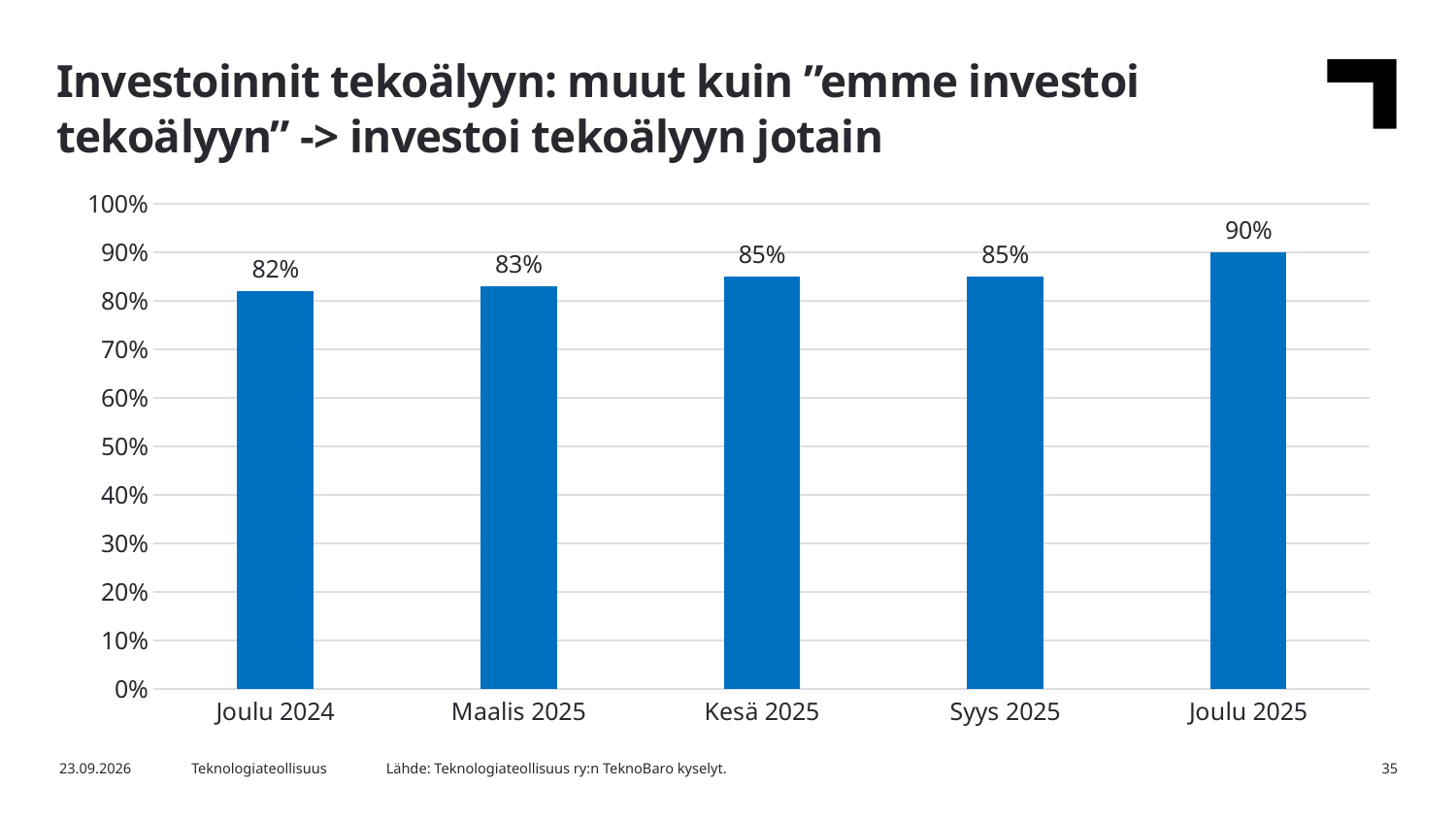
Which category has the lowest value? Joulu 2024 What kind of chart is shown on the slide? bar chart Is the value for Syys 2025 greater or less than 80%? greater What is the value for Kesä 2025? 85% What is the value for Maalis 2025? 83% What is the value for Joulu 2024? 82% How many categories are shown on the x axis? 5 Do the values rise or fall from Joulu 2024 to Joulu 2025? rise Which is larger, the value for Kesä 2025 or the value for Maalis 2025? Kesä 2025 What is the value for Joulu 2025? 90% What is the difference between the values for Joulu 2025 and Joulu 2024? 8% Which category has the highest value? Joulu 2025